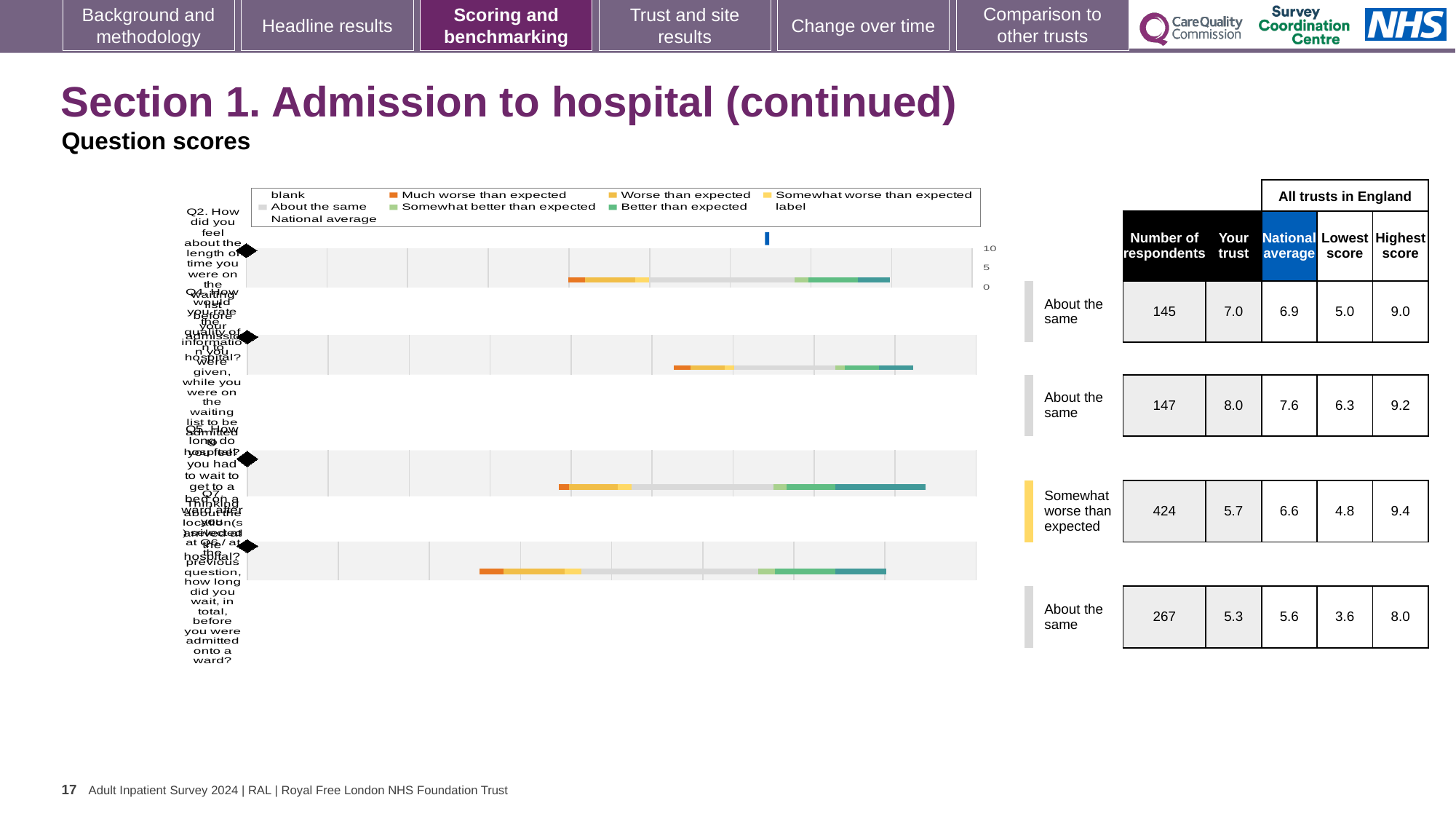
For the second row, which is larger: the 'Your trust' score or the national average? Your trust (8.0) What is the number of respondents for the third row of the chart? 424 What is the 'Your trust' score for the top (first) row of the chart? 7.0 What is the difference between the national average and the 'Your trust' score for the third row? 0.9 Which row has the highest 'Your trust' score? the second row (8.0) Which row has the lowest 'Your trust' score? the bottom (fourth) row (5.3) What is the national average score for the bottom (fourth) row of the chart? 5.6 What kind of chart is shown on the slide? bar chart What is the highest score across all trusts in England for the third row? 9.4 Which row is rated 'Somewhat worse than expected'? the third row What is the lowest score across all trusts in England for the bottom (fourth) row? 3.6 How many question rows (bars) are plotted in the chart? 4